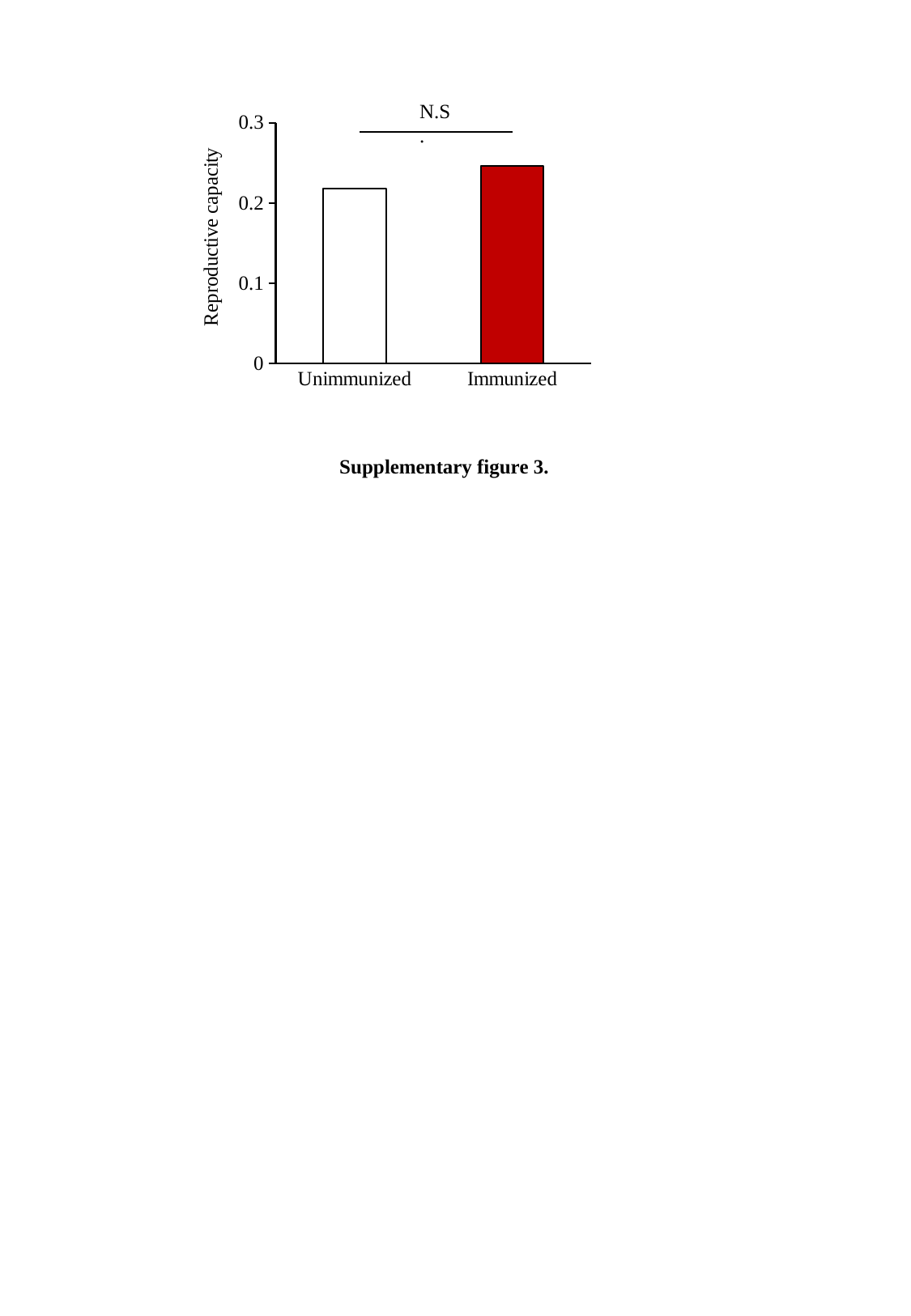
Is the value for Immunized larger or smaller than the value for Unimmunized? larger What colour is the bar for Immunized? red Is the value for Unimmunized greater or less than 0.1? greater Is the value for Unimmunized greater or less than 0.2? greater What is the label on the y axis? Reproductive capacity Which category has the higher reproductive capacity? Immunized How many categories are plotted on the x axis? 2 Is the value for Immunized greater or less than 0.3? less Which category has the lower reproductive capacity? Unimmunized What kind of chart is shown on the slide? bar chart